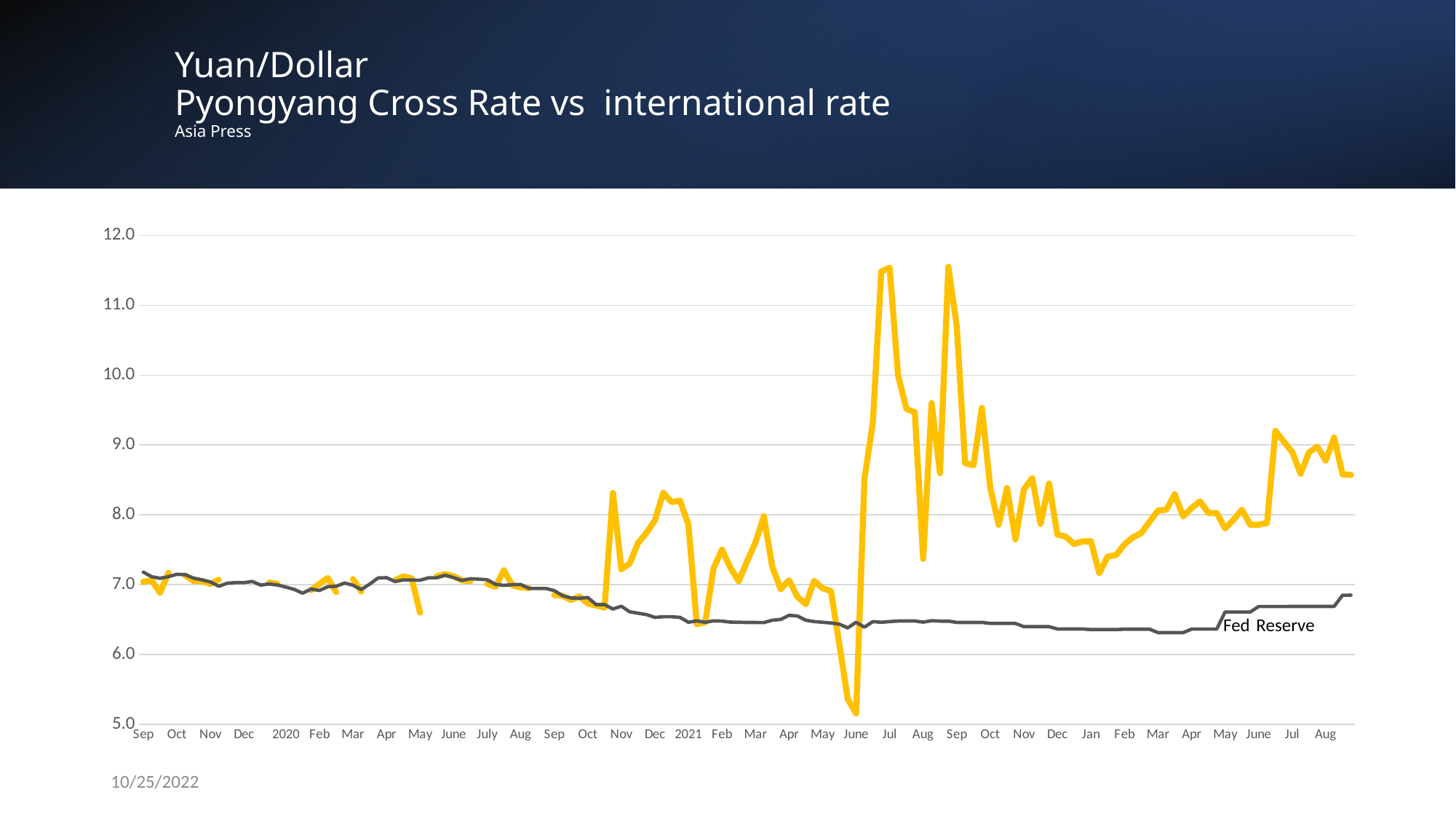
At Nov 2020, which line is higher: the yellow line or the Fed Reserve line? the yellow line Does the Fed Reserve line rise or fall overall from Sep 2019 to Jan 2022? fall At Aug 2022, which line is higher: the yellow line or the Fed Reserve line? the yellow line How many lines (series) are plotted on the chart? 2 Is the Fed Reserve line in Jan 2022 greater or less than 7.0? less Is the peak of the yellow line around Jul 2021 greater or less than 11.0? greater Around which month does the yellow line reach its lowest value? June 2021 Is the lowest point of the yellow line, around June 2021, greater or less than 6.0? less What is the title of the chart on the slide? Yuan/Dollar Pyongyang Cross Rate vs international rate What kind of chart is shown on the slide? line chart What label is printed next to the dark grey line on the chart? Fed Reserve